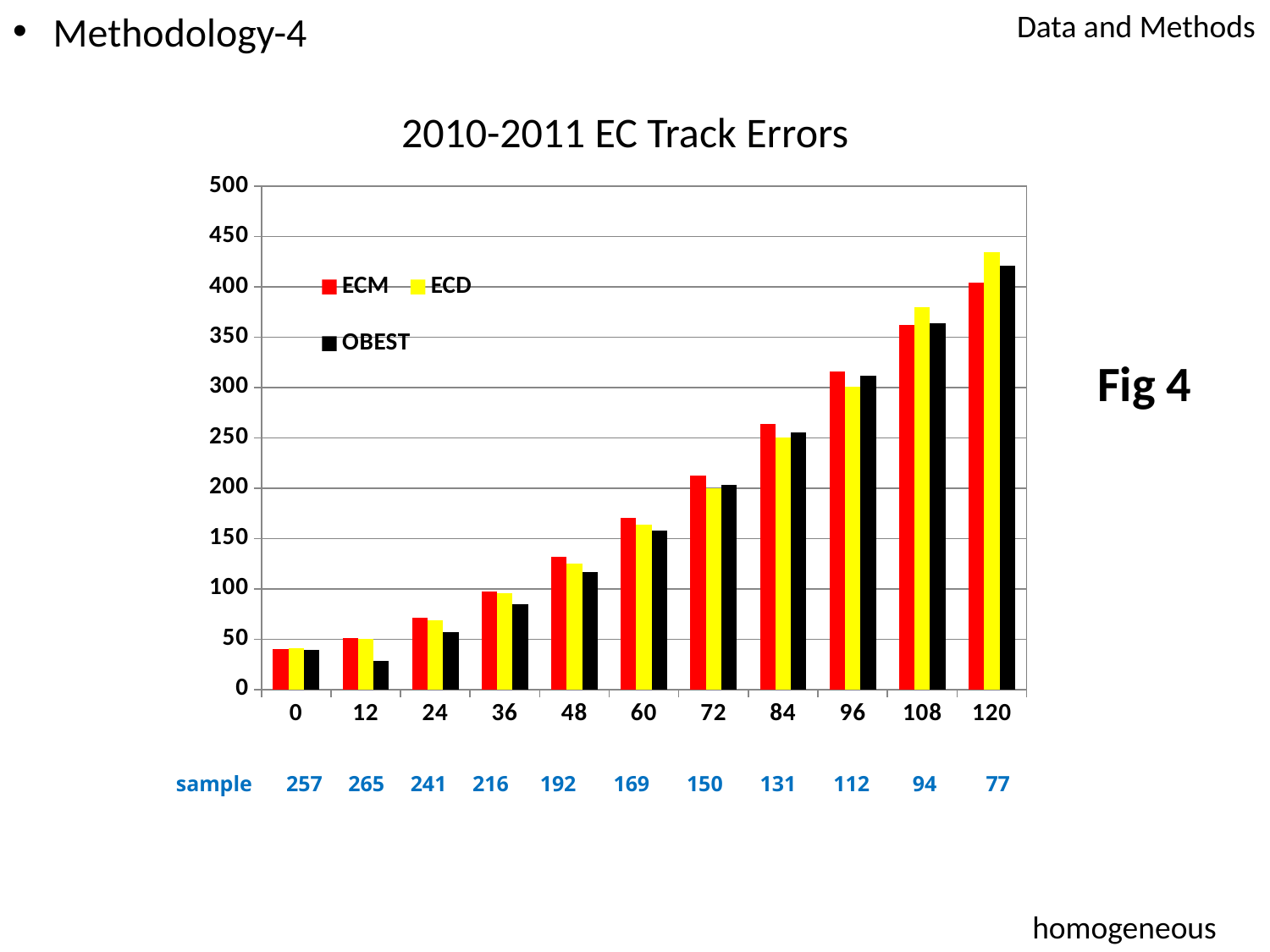
Is the OBEST value at 12 greater or less than 50? less What colour are the OBEST bars in the chart? black How many series does the legend of the 2010-2011 EC Track Errors chart list? 3 What kind of chart is shown on the slide? bar chart Do the ECM values rise or fall as the x-axis values increase from 0 to 120? rise Is the ECD value at 120 greater or less than 400? greater How many categories are shown along the x axis of the chart? 11 At which x-axis category is the OBEST value lowest? 12 At 120, which series has the larger value, ECM or ECD? ECD At 12, which series has the larger value, ECM or OBEST? ECM Is the ECM value at 96 greater or less than 300? greater At which x-axis category is the ECD value highest? 120